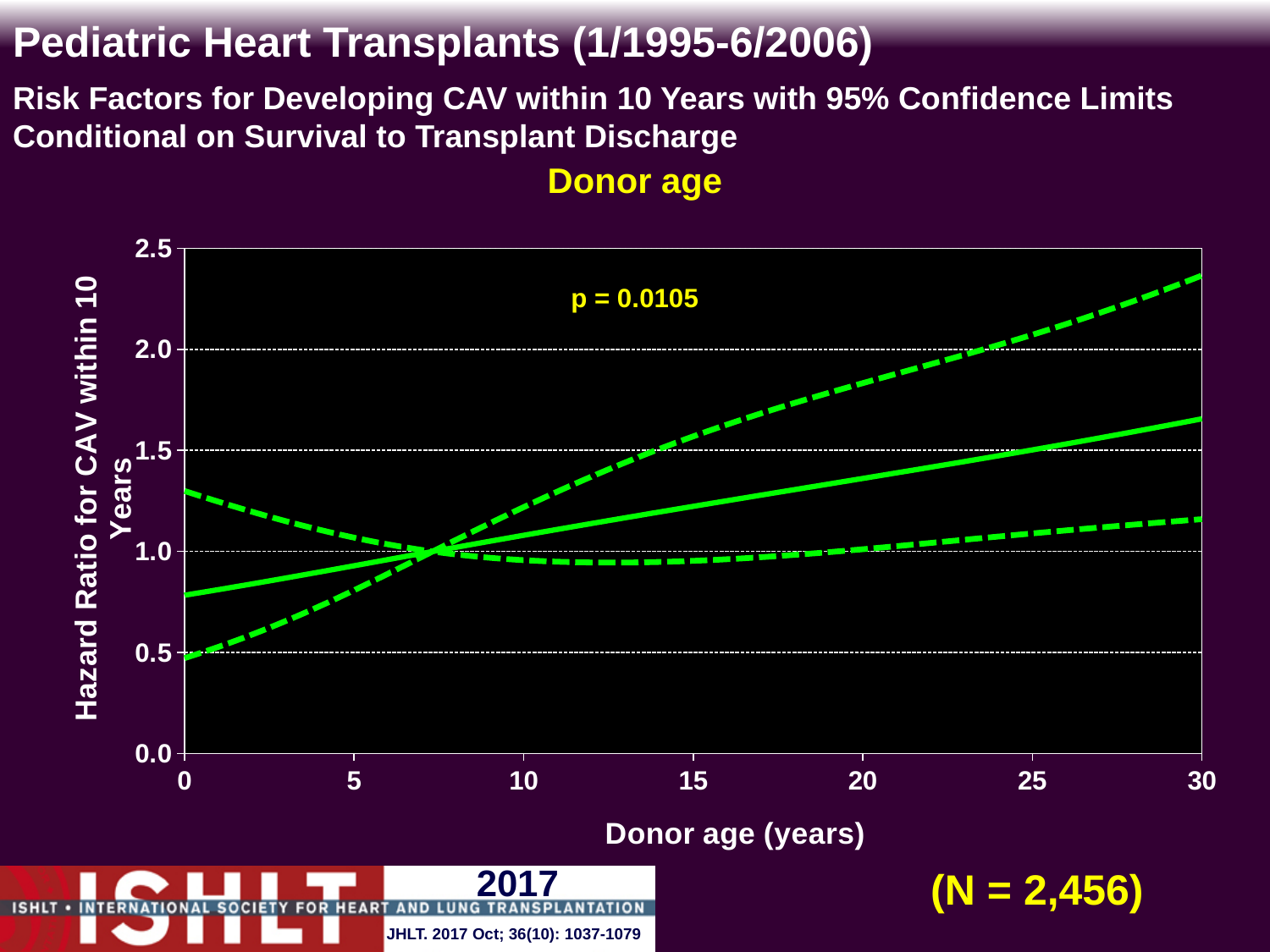
What is the highest donor age shown on the x axis? 30 Is the lower dashed confidence limit at donor age 30 years greater or less than 1.0? greater What kind of chart is shown on the slide? line chart How many lines are plotted on the chart? 3 Does the solid hazard ratio line rise or fall as donor age increases from 0 to 30 years? rise Is the hazard ratio on the solid line at donor age 30 years greater or less than 1.5? greater What is the label of the x axis? Donor age (years) What is the p-value shown on the chart? p = 0.0105 Is the upper dashed confidence limit at donor age 30 years greater or less than 2.0? greater What is the highest value shown on the y axis? 2.5